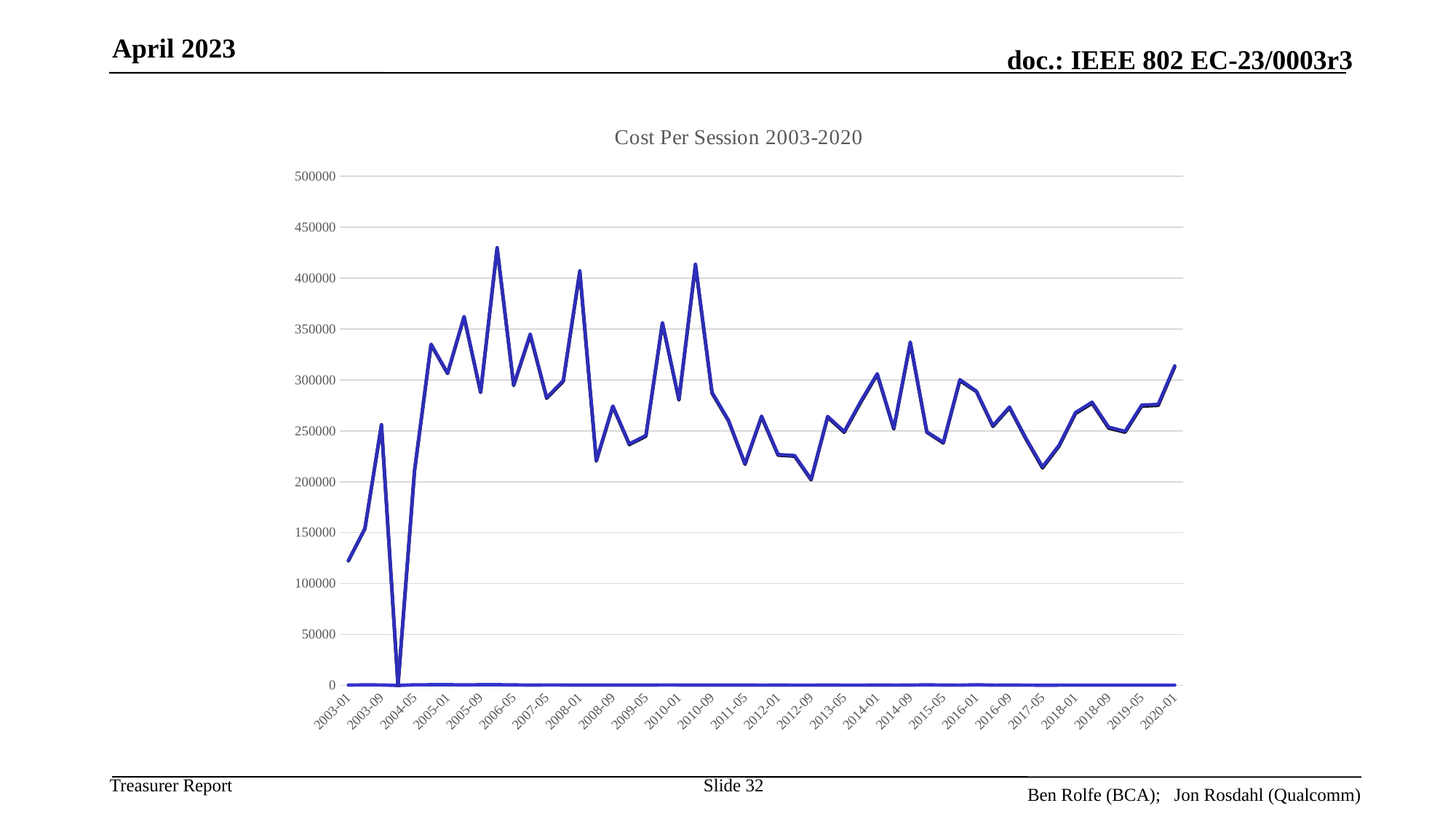
Is the value for 2014-09 greater or less than 300000? greater Does the value rise or fall from 2017-05 to 2020-01? rise Which has the larger value, 2014-09 or 2017-05? 2014-09 Which has the larger value, 2003-01 or 2020-01? 2020-01 Which has the larger value, 2008-01 or 2011-05? 2008-01 Is the value for 2017-05 greater or less than 250000? less What kind of chart is shown on the slide? line chart What is the title of the chart? Cost Per Session 2003-2020 Is the value for 2008-01 greater or less than 350000? greater What is the highest value shown on the y axis? 500000